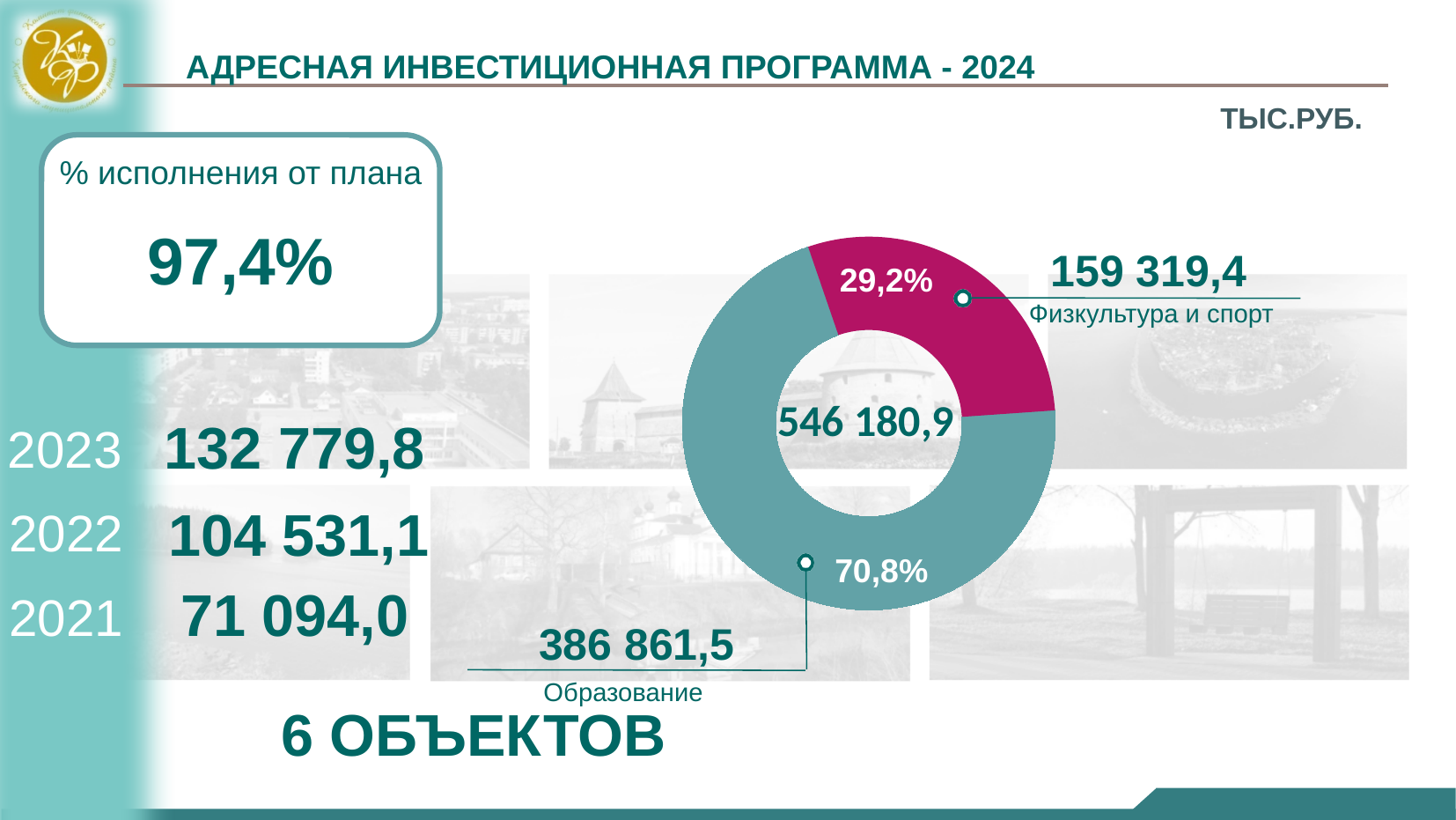
What total is shown in the centre of the donut chart? 546 180,9 Which is larger, the value for Образование or the value for Физкультура и спорт? Образование What is the difference between the values for Образование and Физкультура и спорт? 227 542,1 Which category has the largest slice in the donut chart? Образование What is the value for Физкультура и спорт? 159 319,4 How many slices does the donut chart have? 2 What colour is the Физкультура и спорт slice in the donut chart? Magenta What share of the donut chart does Физкультура и спорт represent? 29,2% Which category has the smallest slice in the donut chart? Физкультура и спорт What share of the donut chart does Образование represent? 70,8% What is the value for Образование? 386 861,5 What kind of chart is shown on the slide? Pie (donut) chart